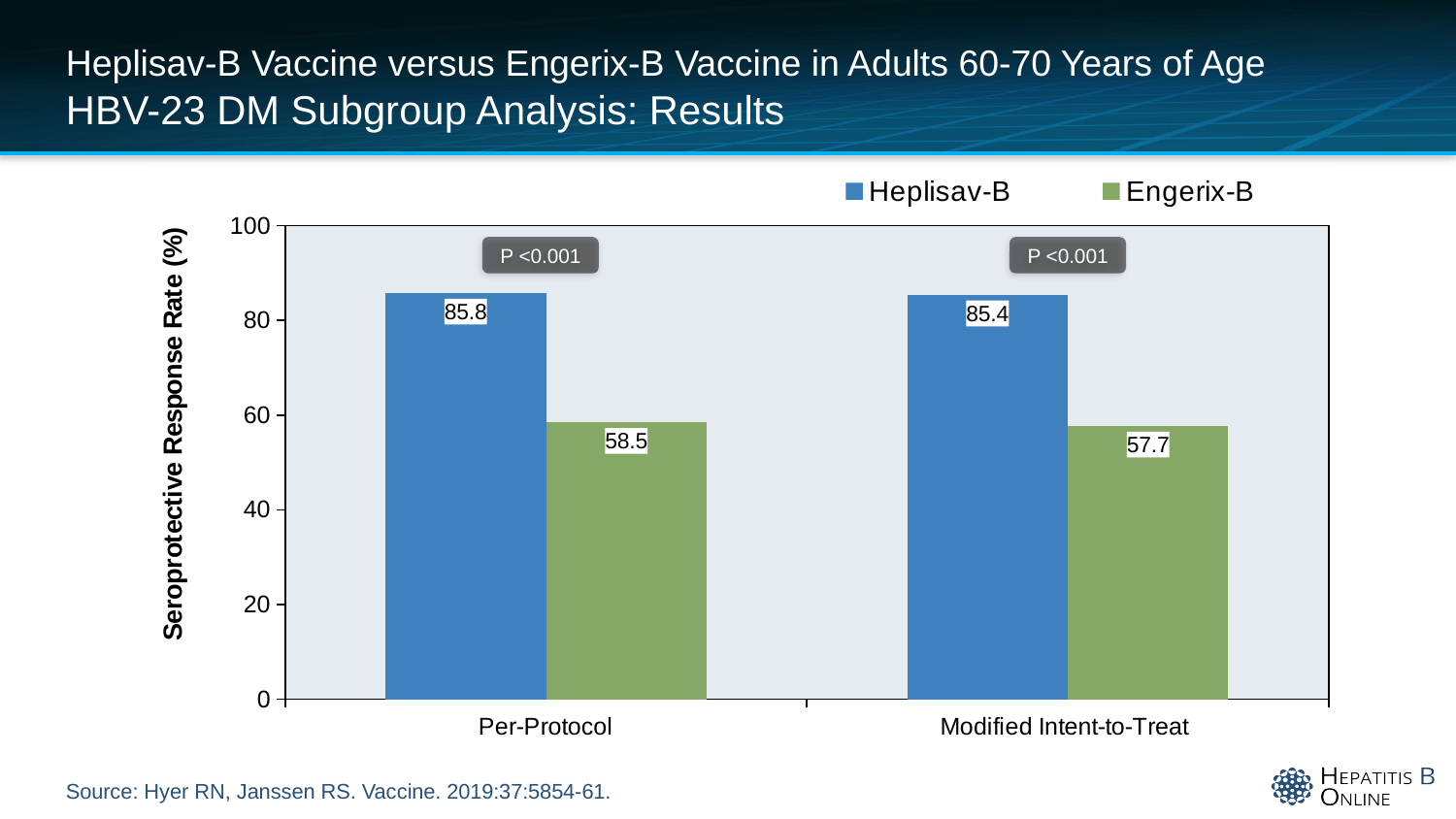
How many series does the legend list? 2 What is the seroprotective response rate for Engerix-B in the Per-Protocol group? 58.5 What is the seroprotective response rate for Heplisav-B in the Modified Intent-to-Treat group? 85.4 Which vaccine has the higher seroprotective response rate in the Per-Protocol group? Heplisav-B What is the difference between the Heplisav-B and Engerix-B response rates in the Per-Protocol group? 27.3 Which bar shows the lowest seroprotective response rate on the chart? Engerix-B, Modified Intent-to-Treat What is the difference between the Heplisav-B and Engerix-B response rates in the Modified Intent-to-Treat group? 27.7 What kind of chart is shown on the slide? Bar chart What is the seroprotective response rate for Heplisav-B in the Per-Protocol group? 85.8 How many analysis groups are shown on the x axis? 2 What is the seroprotective response rate for Engerix-B in the Modified Intent-to-Treat group? 57.7 What is the label of the y axis? Seroprotective Response Rate (%)